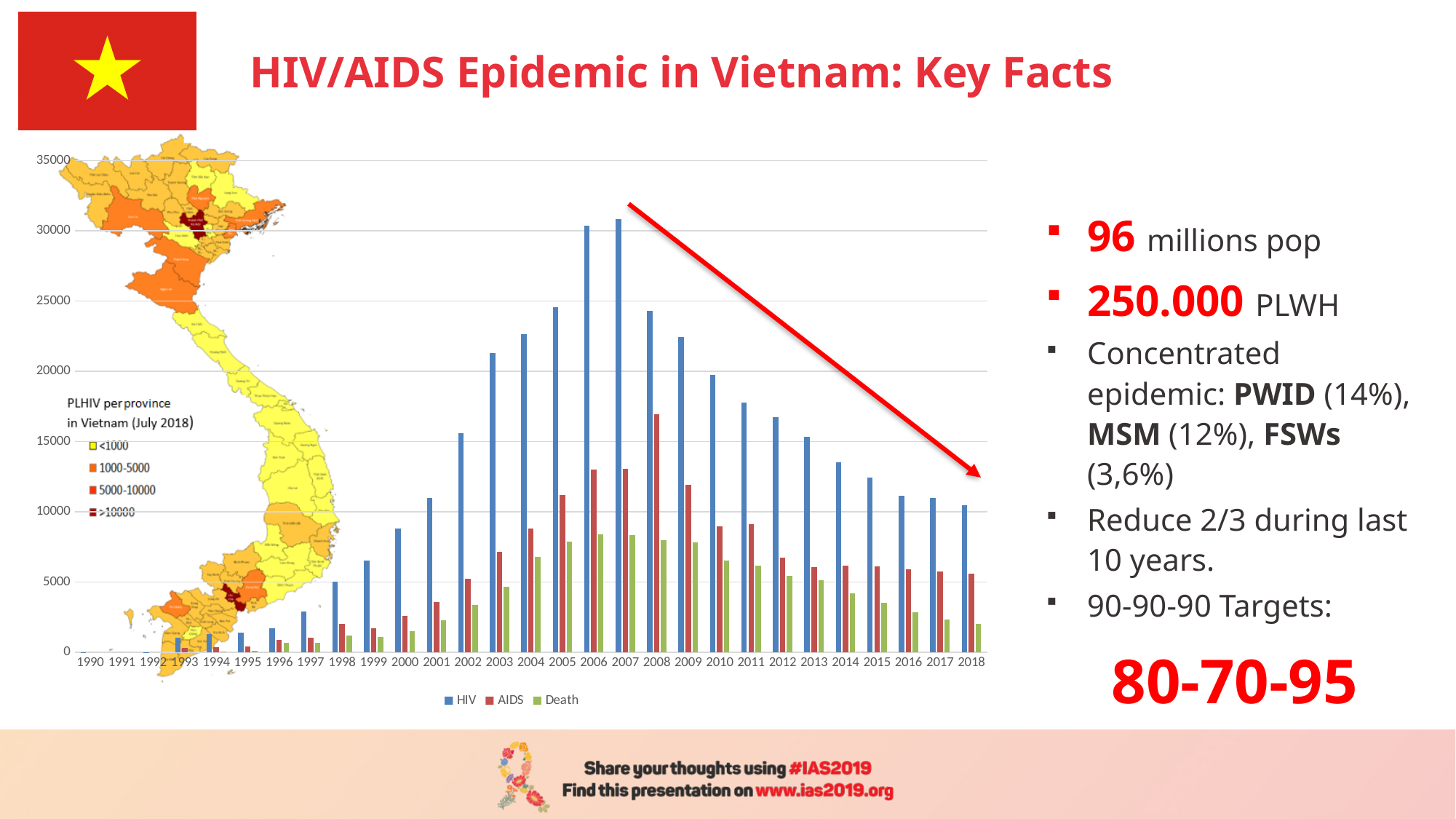
Is the HIV value for 2007 greater or less than 30000? greater Is the AIDS value for 2008 greater or less than 15000? greater How many series does the chart legend list? 3 In which year is the AIDS value highest? 2008 Is the HIV value for 2004 greater or less than 20000? greater Do the HIV values rise or fall from 2007 to 2018? fall Do the HIV values rise or fall from 1990 to 2007? rise Which is larger, the HIV value for 2010 or the HIV value for 2015? 2010 What kind of chart is shown on the slide? bar chart How many years are shown along the x axis of the chart? 29 Which colour represents the HIV series in the chart? blue